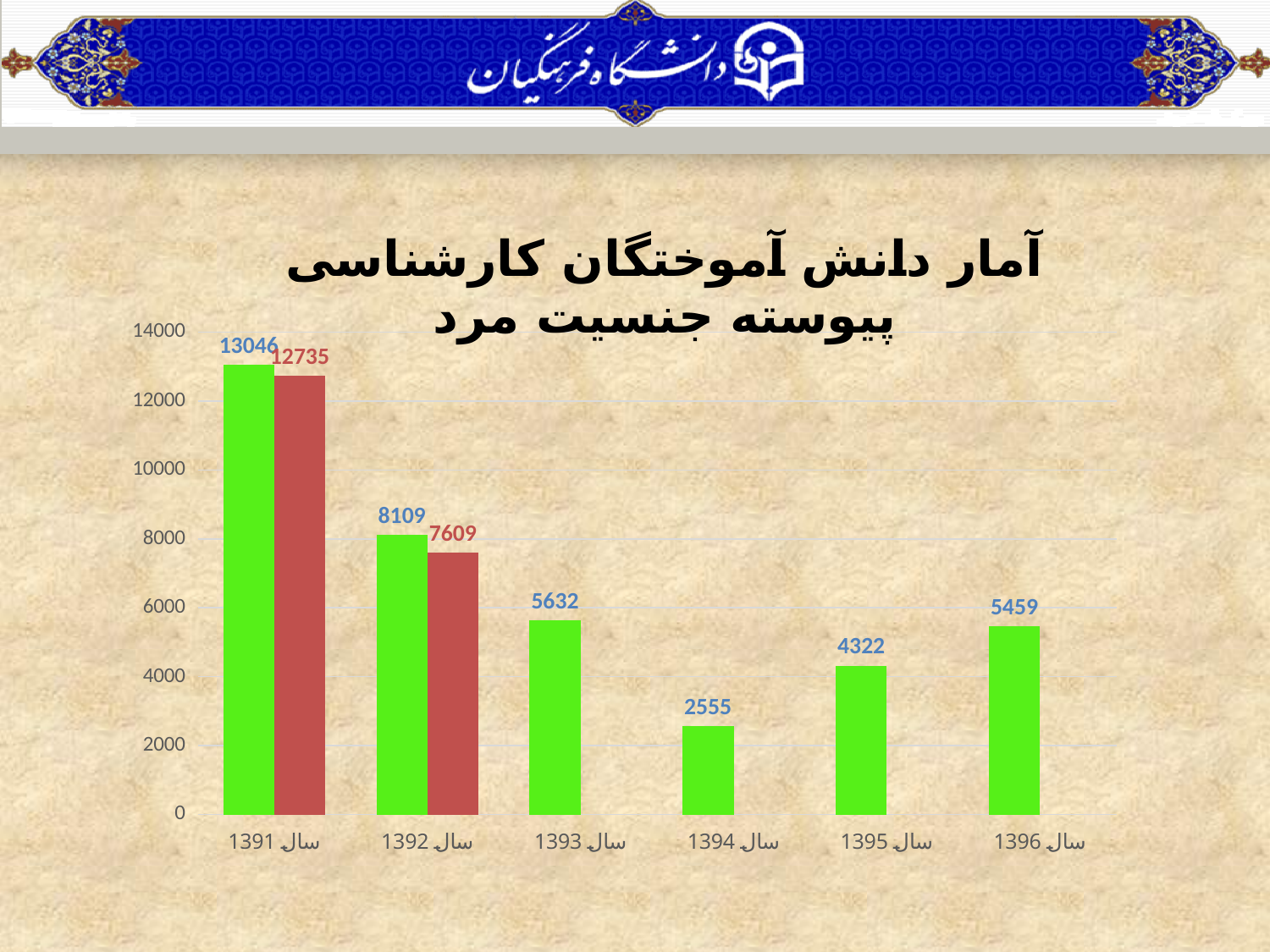
What is the value of the green bar for سال 1396? 5459 Which is larger, the green bar for سال 1395 or the green bar for سال 1396? سال 1396 How many year categories are shown on the x axis? 6 What is the difference between the green and red bars for سال 1391? 311 What is the value of the green bar for سال 1391? 13046 What type of chart is shown on the slide? bar chart What is the difference between the green bars for سال 1393 and سال 1395? 1310 Do the green bars rise or fall from سال 1391 to سال 1394? fall Which year has the highest green bar? سال 1391 What is the value of the red bar for سال 1392? 7609 What is the value of the green bar for سال 1394? 2555 Which year has the lowest green bar? سال 1394